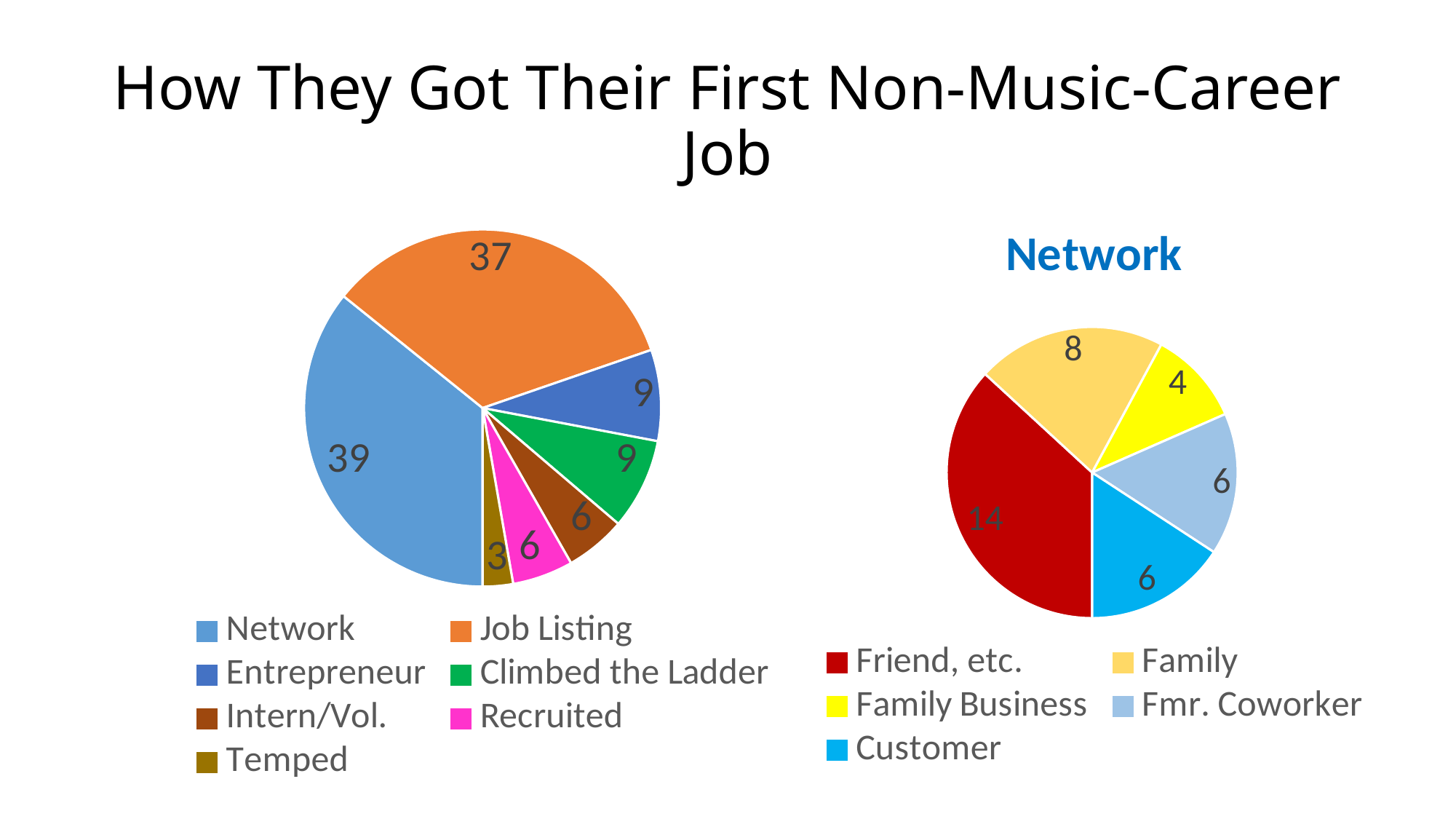
In the left pie chart, how many categories are shown? 7 In the Network pie chart, which category has the smallest slice? Family Business What type of chart is the Network chart? Pie chart In the left pie chart, what is the difference between the Network and Job Listing values? 2 In the Network pie chart, which is larger, Family or Fmr. Coworker? Family In the Network pie chart, which category has the largest slice? Friend, etc. In the left pie chart, which category has the smallest slice? Temped In the Network pie chart, what is the value for Family? 8 In the left pie chart, what is the value for Job Listing? 37 In the left pie chart, what is the value for Temped? 3 In the left pie chart, which category has the largest slice? Network In the Network pie chart, what is the difference between Friend, etc. and Family Business? 10